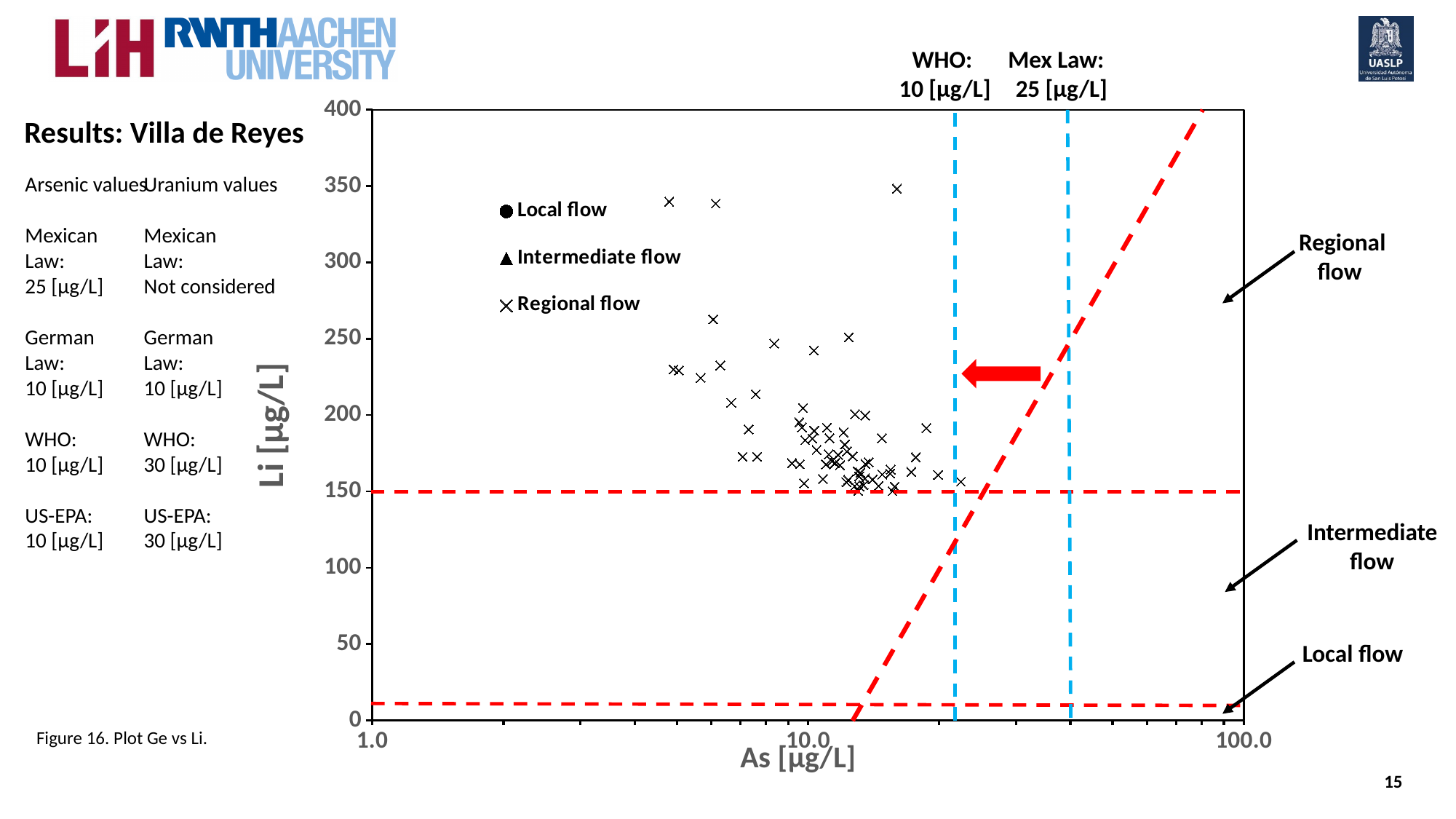
Is the lowest Li value plotted on the chart greater or less than 100? greater What is the label of the y axis of the chart? Li [µg/L] What As concentration does the Mex Law vertical dashed line mark? 25 [µg/L] What As concentration does the WHO vertical dashed line mark? 10 [µg/L] Which series in the legend is plotted with an x marker? Regional flow What is the maximum value shown on the x axis of the chart? 100.0 Are the plotted points to the left or to the right of the Mex Law 25 [µg/L] line? left What is the label of the x axis of the chart? As [µg/L] What kind of chart is shown on the slide? Scatter plot How many series does the chart legend list? 3 Is the highest Li value plotted on the chart greater or less than 300? greater What is the maximum value shown on the y axis of the chart? 400